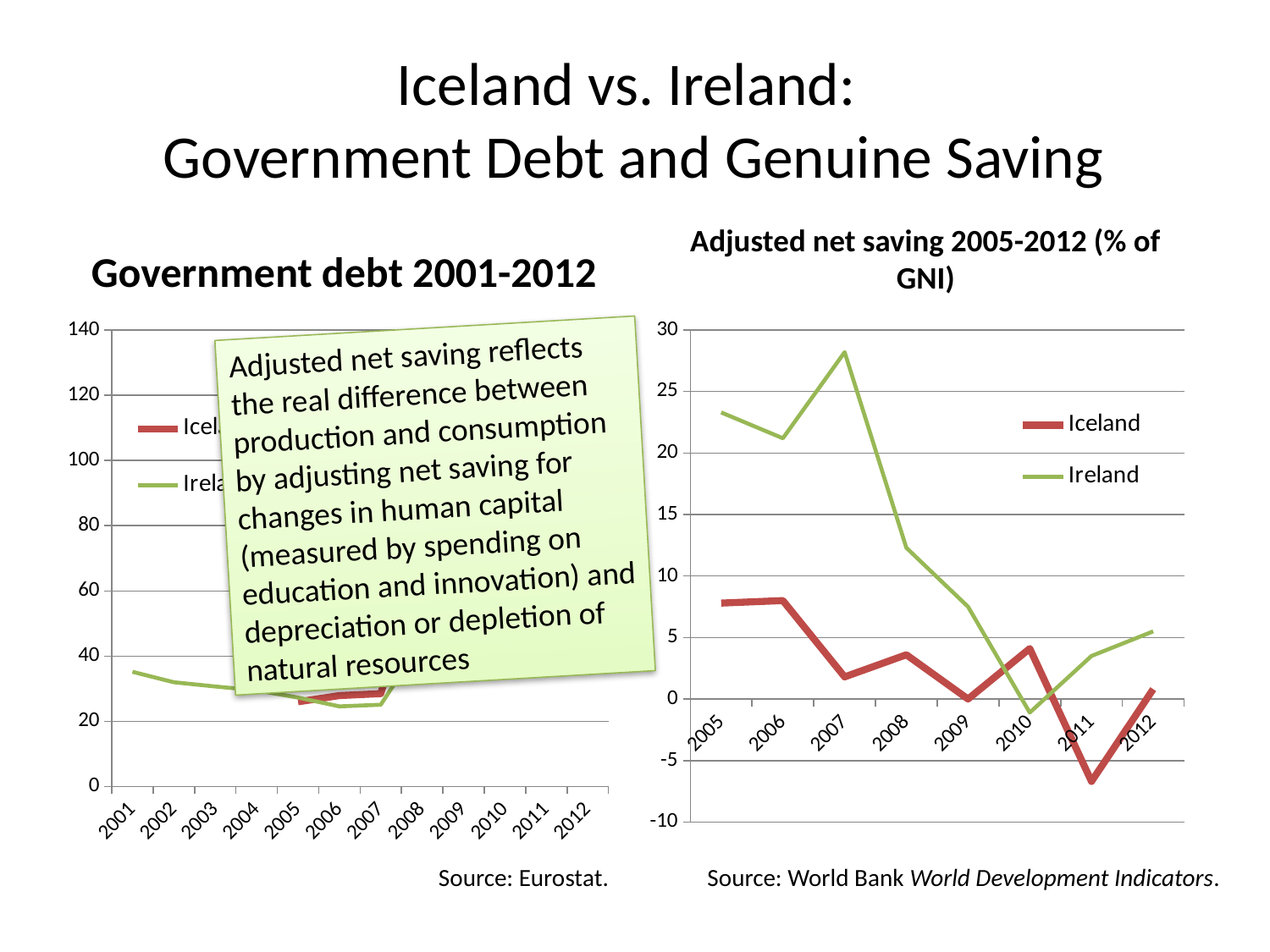
What source is cited for the 'Adjusted net saving 2005-2012 (% of GNI)' chart? World Bank World Development Indicators How many years are shown on the x axis of the 'Government debt 2001-2012' chart? 12 What kind of chart is the 'Adjusted net saving 2005-2012 (% of GNI)' chart? line chart In the 'Adjusted net saving 2005-2012 (% of GNI)' chart, which country has the larger value in 2010, Iceland or Ireland? Iceland In the 'Adjusted net saving 2005-2012 (% of GNI)' chart, is the value for Ireland in 2007 greater or less than 25? greater How many years are shown on the x axis of the 'Adjusted net saving 2005-2012 (% of GNI)' chart? 8 In the 'Adjusted net saving 2005-2012 (% of GNI)' chart, is the value for Iceland in 2011 greater or less than -5? less How many series does the legend of the 'Adjusted net saving 2005-2012 (% of GNI)' chart list? 2 In the 'Adjusted net saving 2005-2012 (% of GNI)' chart, in which year does Iceland reach its lowest value? 2011 In the 'Adjusted net saving 2005-2012 (% of GNI)' chart, is the value for Iceland in 2005 greater or less than 10? less In the 'Adjusted net saving 2005-2012 (% of GNI)' chart, does Ireland's value rise or fall from 2007 to 2010? fall In the 'Adjusted net saving 2005-2012 (% of GNI)' chart, in which year does Ireland reach its highest value? 2007